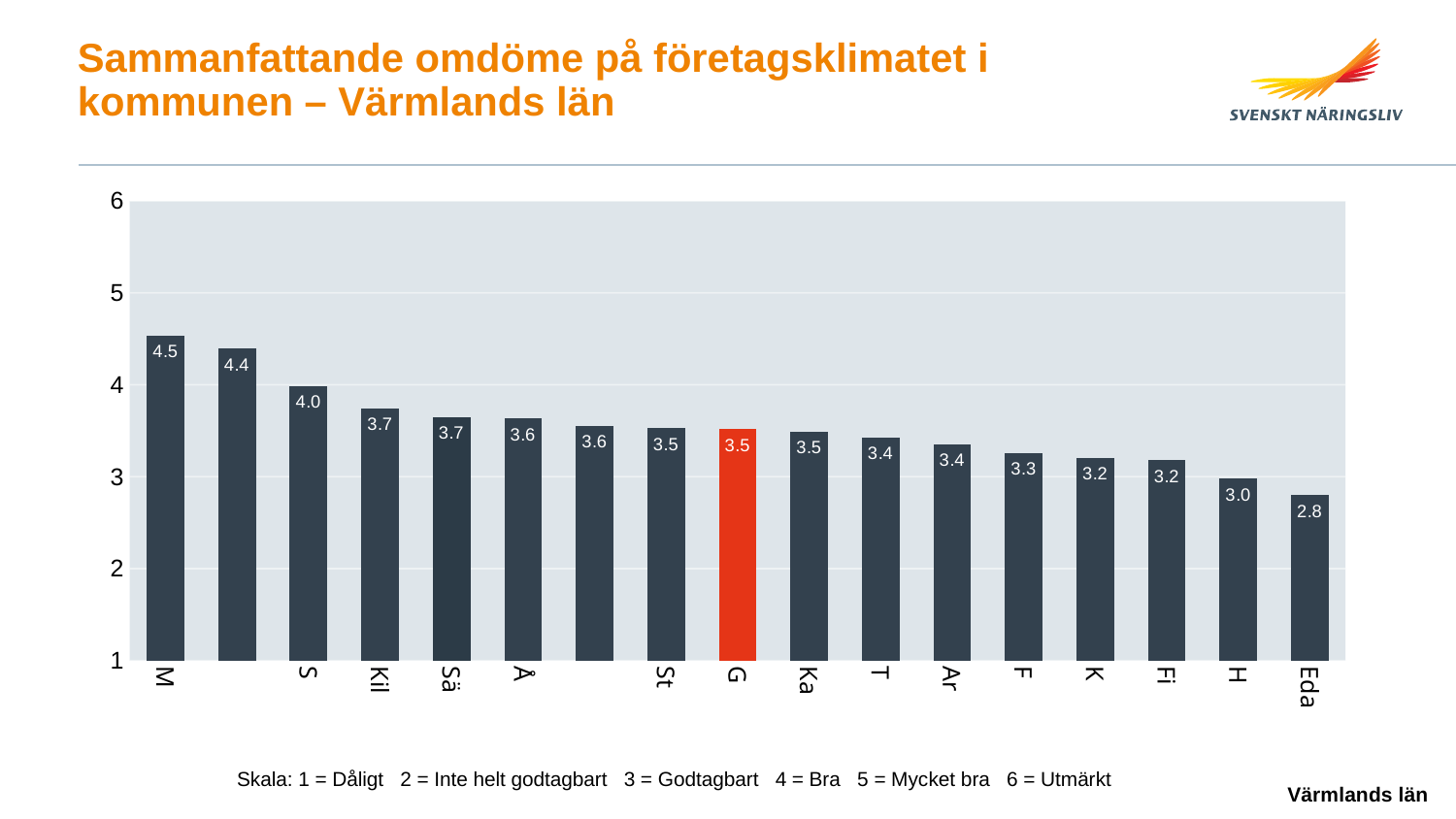
Which category has the lowest value in the chart? Eda What is the value for Ar? 3.4 What is the value for Kil? 3.7 How many bars are shown in the chart? 17 What is the highest value shown in the chart? 4.5 What is the value for Eda? 2.8 What kind of chart is shown on the slide? bar chart Which has a larger value, Kil or Fi? Kil What is the difference between the highest value (4.5) and the lowest value (2.8)? 1.7 Do the values rise or fall from left to right along the x axis? fall What is the value of the highlighted red bar (G)? 3.5 Is the value for Eda greater or less than 3? less